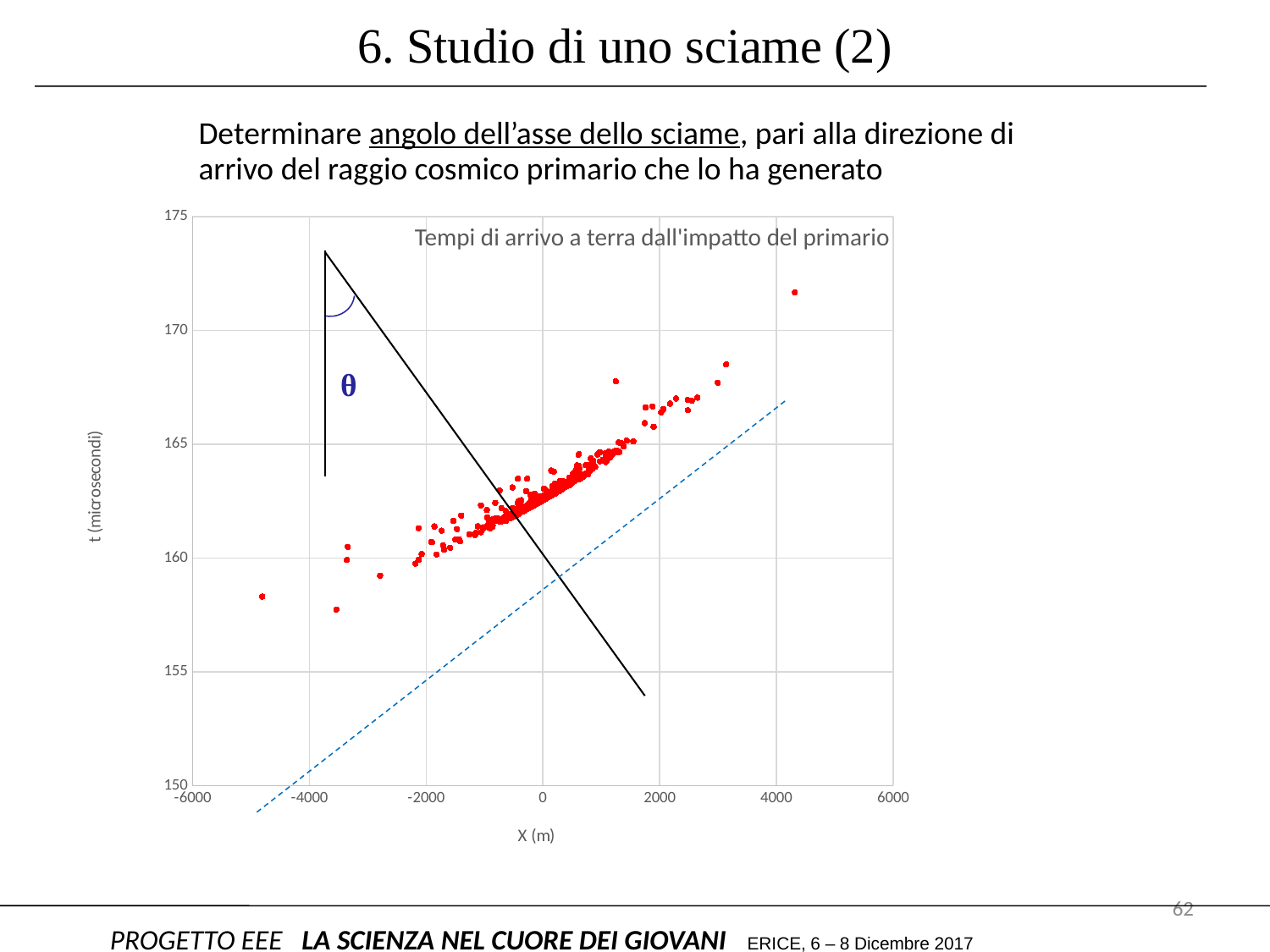
Are the arrival times of the points near X = 0 m greater or less than 160 microseconds? greater What is the maximum value shown on the y axis of the chart? 175 Is the arrival time of the rightmost point (near X = 4000 m) greater or less than 170 microseconds? greater What is the label of the x axis of the chart? X (m) Do the plotted arrival times generally rise or fall as X increases along the x axis? rise Is the arrival time of the leftmost point (near X = -5000 m) greater or less than 160 microseconds? less What kind of chart is shown on the slide? scatter chart Which has the larger arrival time: the point near X = 4000 m or the point near X = -5000 m? the point near X = 4000 m What is the title of the chart? Tempi di arrivo a terra dall'impatto del primario